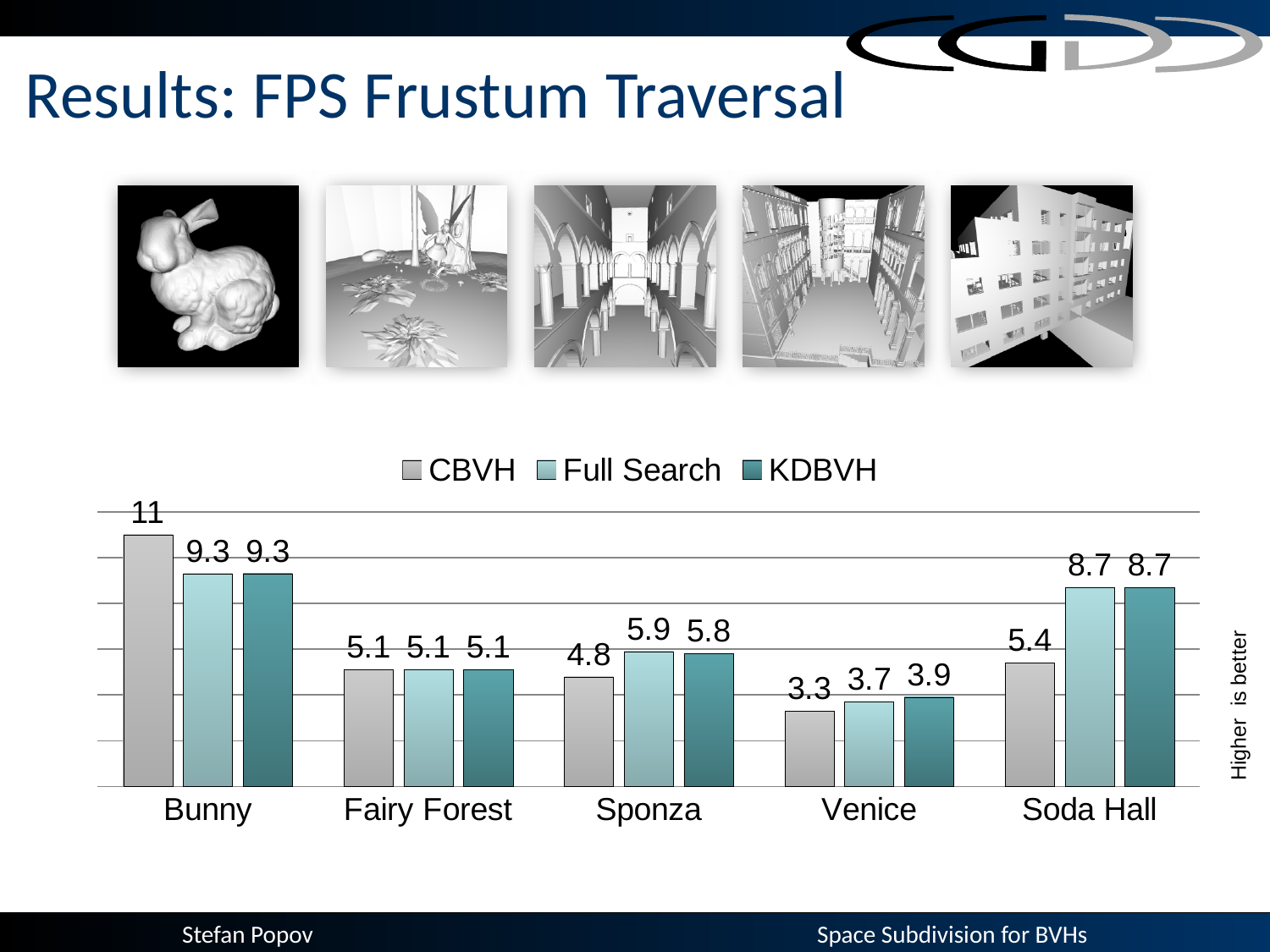
What kind of chart is shown on the slide? bar chart What is the Full Search value for Soda Hall? 8.7 What is the KDBVH value for Venice? 3.9 Which scene has the highest CBVH value? Bunny What is the difference between the Full Search and CBVH values for Soda Hall? 3.3 Which scene has the lowest Full Search value? Venice Which is larger for Sponza: the CBVH value or the Full Search value? Full Search What is the CBVH value for Bunny? 11 How many series does the legend list? 3 What is the difference between the CBVH and Full Search values for Bunny? 1.7 How many scenes are shown on the x axis of the chart? 5 What are the three series named in the legend? CBVH, Full Search, KDBVH